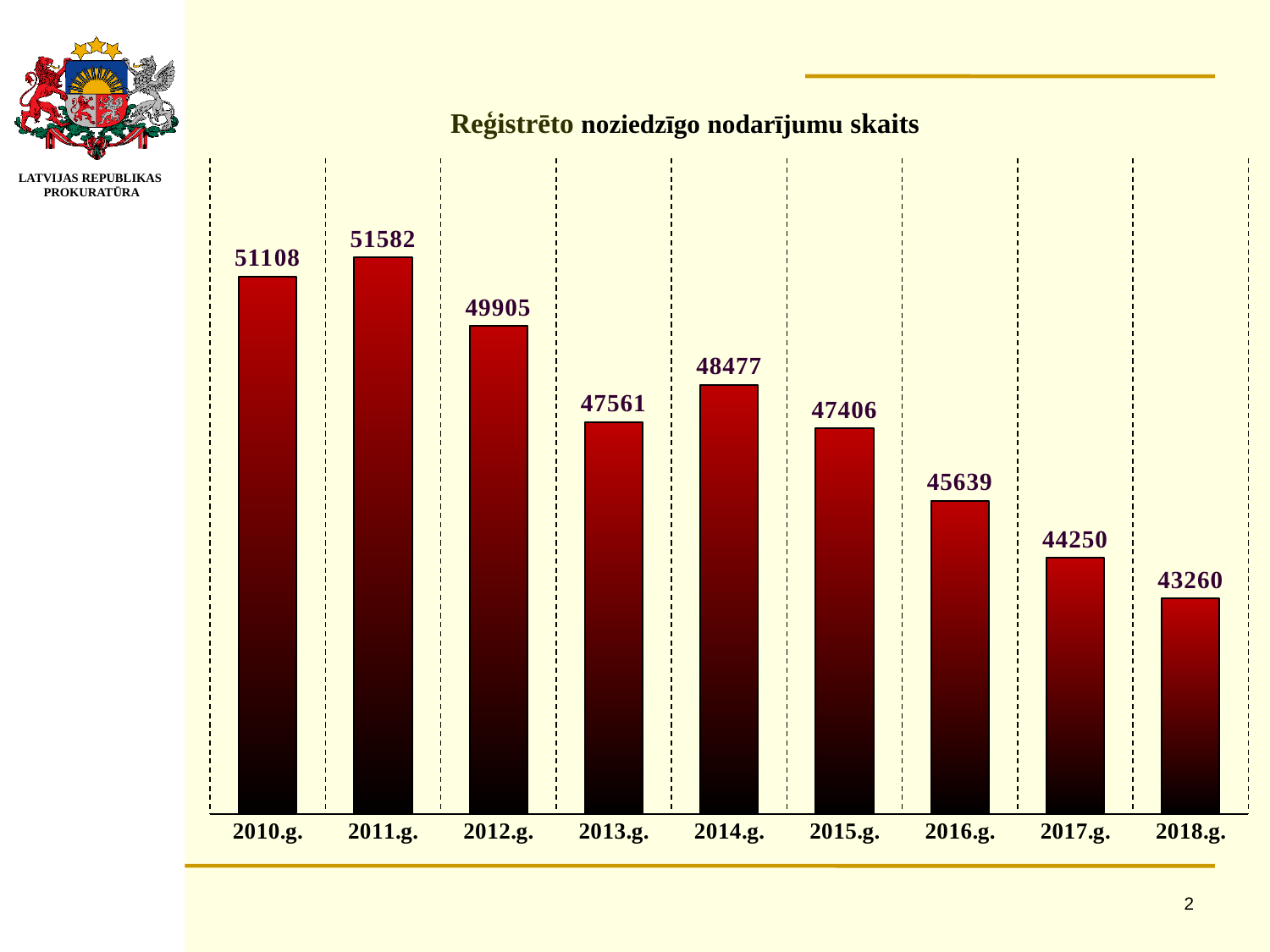
Which year has the lowest value? 2018.g. Do the values generally rise or fall from 2011.g. to 2018.g.? fall What is the difference between the values for 2012.g. and 2013.g.? 2344 What is the value for 2014.g.? 48477 How many years are shown on the x axis? 9 What is the difference between the values for 2011.g. and 2018.g.? 8322 What is the title of the chart? Reģistrēto noziedzīgo nodarījumu skaits Which is larger, the value for 2013.g. or the value for 2015.g.? 2013.g. What is the value for 2010.g.? 51108 What kind of chart is this? bar chart What is the value for 2018.g.? 43260 Which year has the highest value? 2011.g.